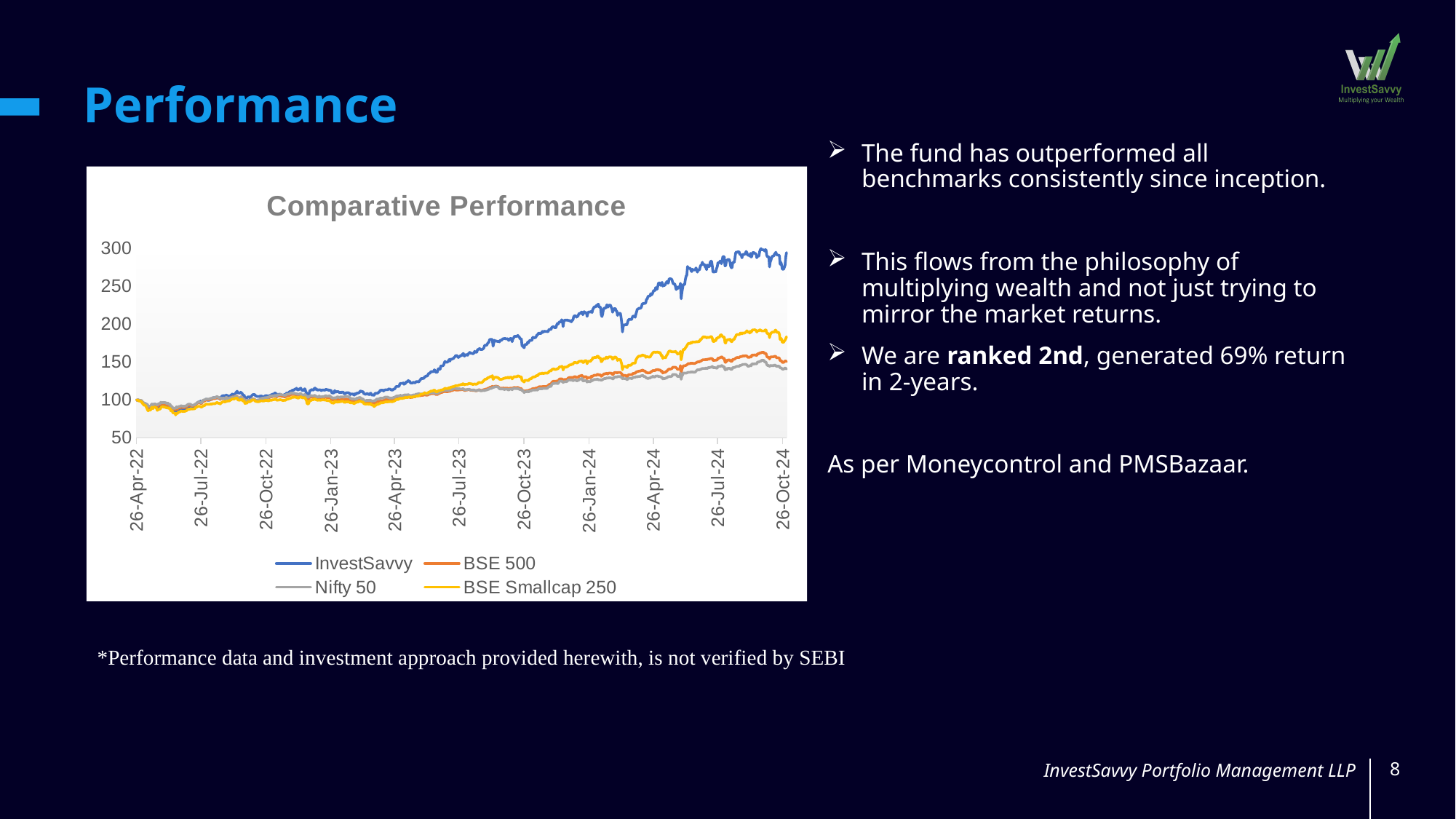
How many series does the chart's legend list? 4 Does the InvestSavvy line generally rise or fall from 26-Apr-22 to 26-Oct-24? Rise What is the title of the chart? Comparative Performance What is the first date label on the x axis? 26-Apr-22 What kind of chart is shown on the slide? Line chart Which series is plotted with the blue line? InvestSavvy Which series reaches the highest value at the end of the chart (26-Oct-24)? InvestSavvy At 26-Oct-24, which is larger: InvestSavvy or BSE 500? InvestSavvy Is the value of InvestSavvy at 26-Oct-24 greater or less than 250? greater Which series has the lowest value at the end of the chart (26-Oct-24)? Nifty 50 Is the value of BSE Smallcap 250 at 26-Oct-24 greater or less than 150? greater Is the value of Nifty 50 at 26-Oct-24 greater or less than 150? less